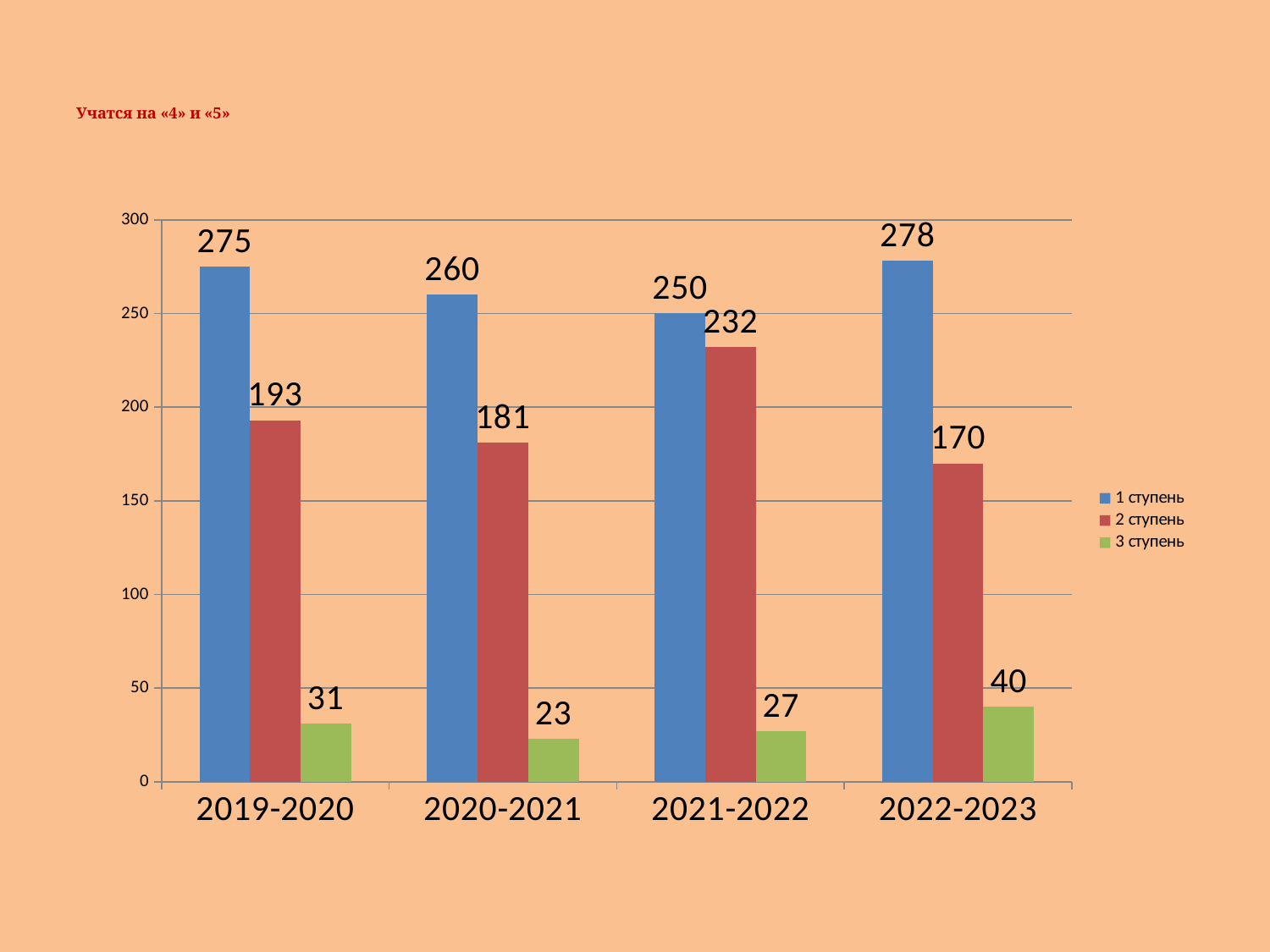
What kind of chart is shown on the slide? Bar chart What is the value for 3 ступень in 2020-2021? 23 How many series does the legend list? 3 How many school years are shown on the x axis? 4 In which year is the value for 1 ступень highest? 2022-2023 In which year is the value for 3 ступень lowest? 2020-2021 Is the value for 2 ступень in 2021-2022 greater or less than 200? greater What is the title of the slide? Учатся на «4» и «5» What is the value for 1 ступень in 2019-2020? 275 Which is larger: the 2 ступень value in 2019-2020 or in 2020-2021? 2019-2020 What is the difference between the 1 ступень and 2 ступень values in 2022-2023? 108 What is the value for 2 ступень in 2021-2022? 232